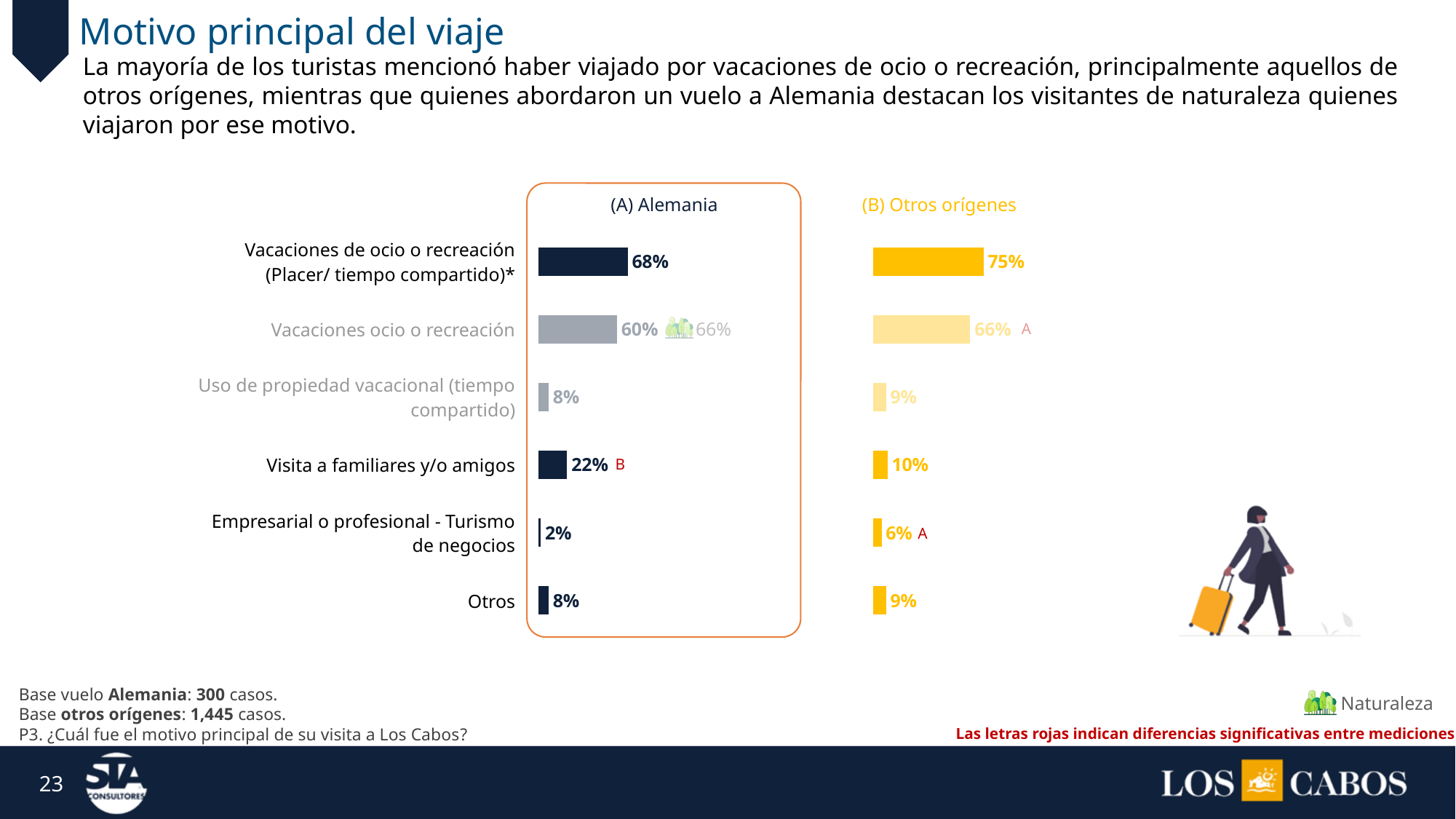
In the (B) Otros orígenes chart, what is the value for Vacaciones de ocio o recreación (Placer/ tiempo compartido)*? 75% In the (A) Alemania chart, which category has the highest value? Vacaciones de ocio o recreación (Placer/ tiempo compartido)* In the (A) Alemania chart, which category has the lowest value? Empresarial o profesional - Turismo de negocios In the (B) Otros orígenes chart, what is the value for Uso de propiedad vacacional (tiempo compartido)? 9% In the (A) Alemania chart, what is the value for Visita a familiares y/o amigos? 22% What is the difference between the (B) Otros orígenes and (A) Alemania values for Empresarial o profesional - Turismo de negocios? 4 percentage points In the (B) Otros orígenes chart, which category has the lowest value? Empresarial o profesional - Turismo de negocios Which is larger for Vacaciones ocio o recreación: the (A) Alemania value or the (B) Otros orígenes value? (B) Otros orígenes How many categories are shown in the (A) Alemania chart? 6 In the (A) Alemania chart, what is the value for Empresarial o profesional - Turismo de negocios? 2% What is the difference between the (A) Alemania and (B) Otros orígenes values for Visita a familiares y/o amigos? 12 percentage points What kind of chart is used for (A) Alemania? Bar chart